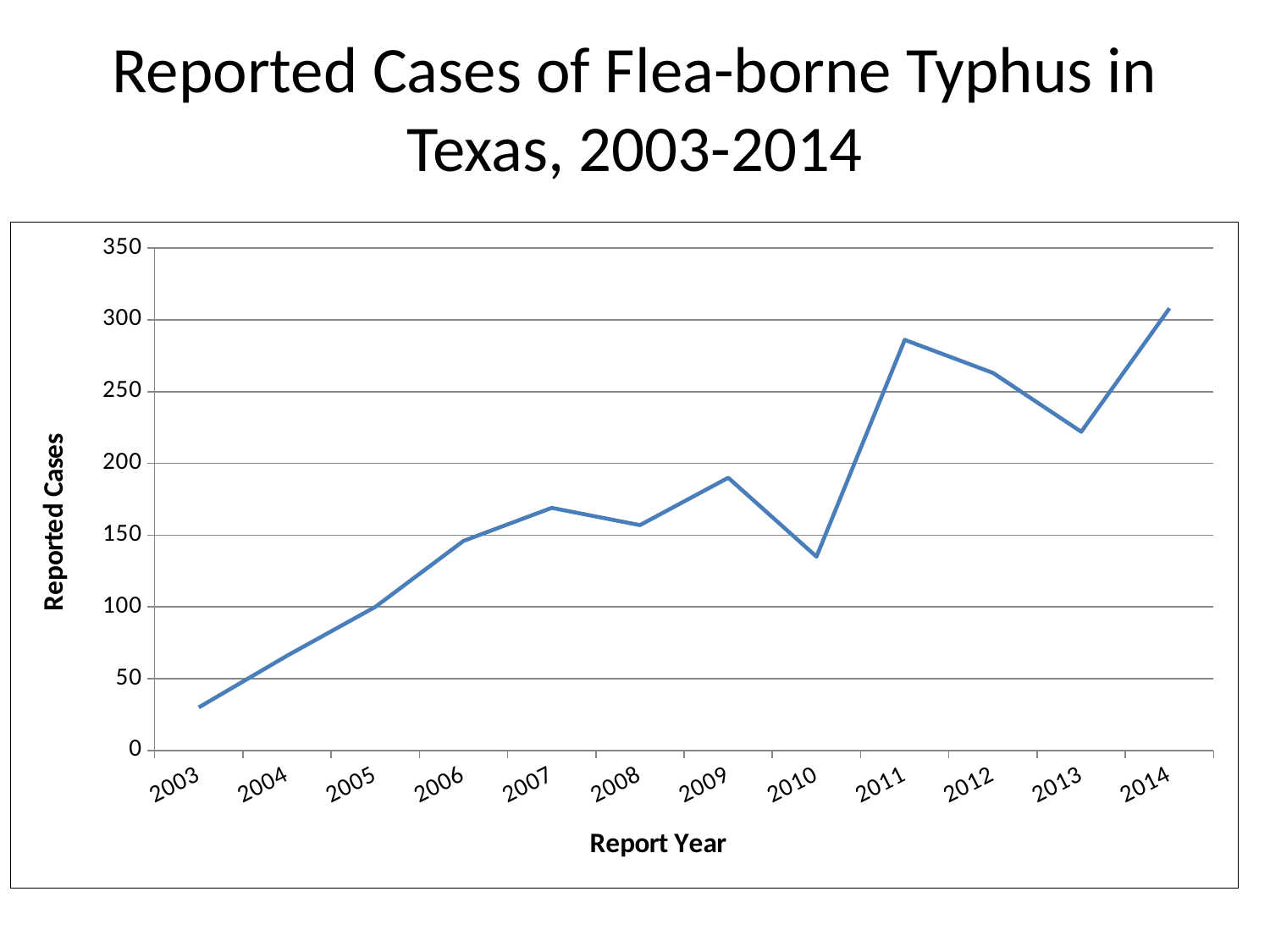
Is the value for 2014 greater or less than 300? greater Which year has the lowest number of reported cases? 2003 Which year has the highest number of reported cases? 2014 Is the value for 2010 greater or less than 150? less Is the value for 2011 greater or less than 250? greater What is the label of the y axis? Reported Cases Which year has more reported cases, 2009 or 2010? 2009 How many years are plotted on the x axis? 12 What kind of chart is shown on the slide? line chart Which year has more reported cases, 2012 or 2013? 2012 Overall, do reported cases rise or fall from 2003 to 2014? rise